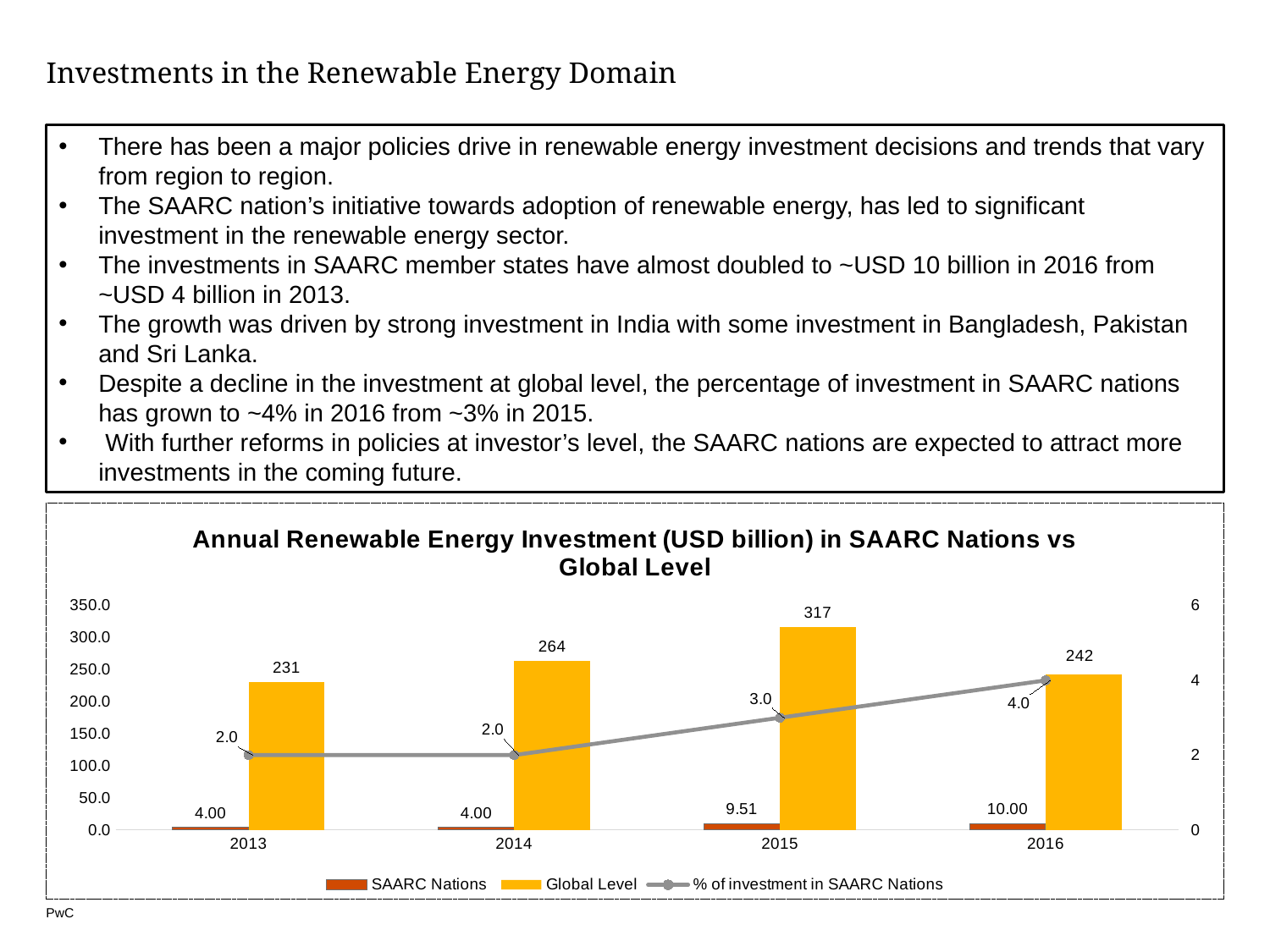
What is the difference between the Global Level values for 2015 and 2016? 75 How many years are shown on the x axis? 4 What is the title of the chart? Annual Renewable Energy Investment (USD billion) in SAARC Nations vs Global Level Does the % of investment in SAARC Nations rise or fall from 2014 to 2016? rise What is the SAARC Nations investment value for 2016? 10.00 Which is larger, the Global Level value for 2014 or for 2016? 2014 Which year has the highest Global Level investment? 2015 What is the difference between the SAARC Nations values for 2016 and 2015? 0.49 What is the % of investment in SAARC Nations for 2014? 2.0 Which year has the lowest Global Level investment? 2013 How many series does the legend list? 3 What is the Global Level investment value for 2015? 317